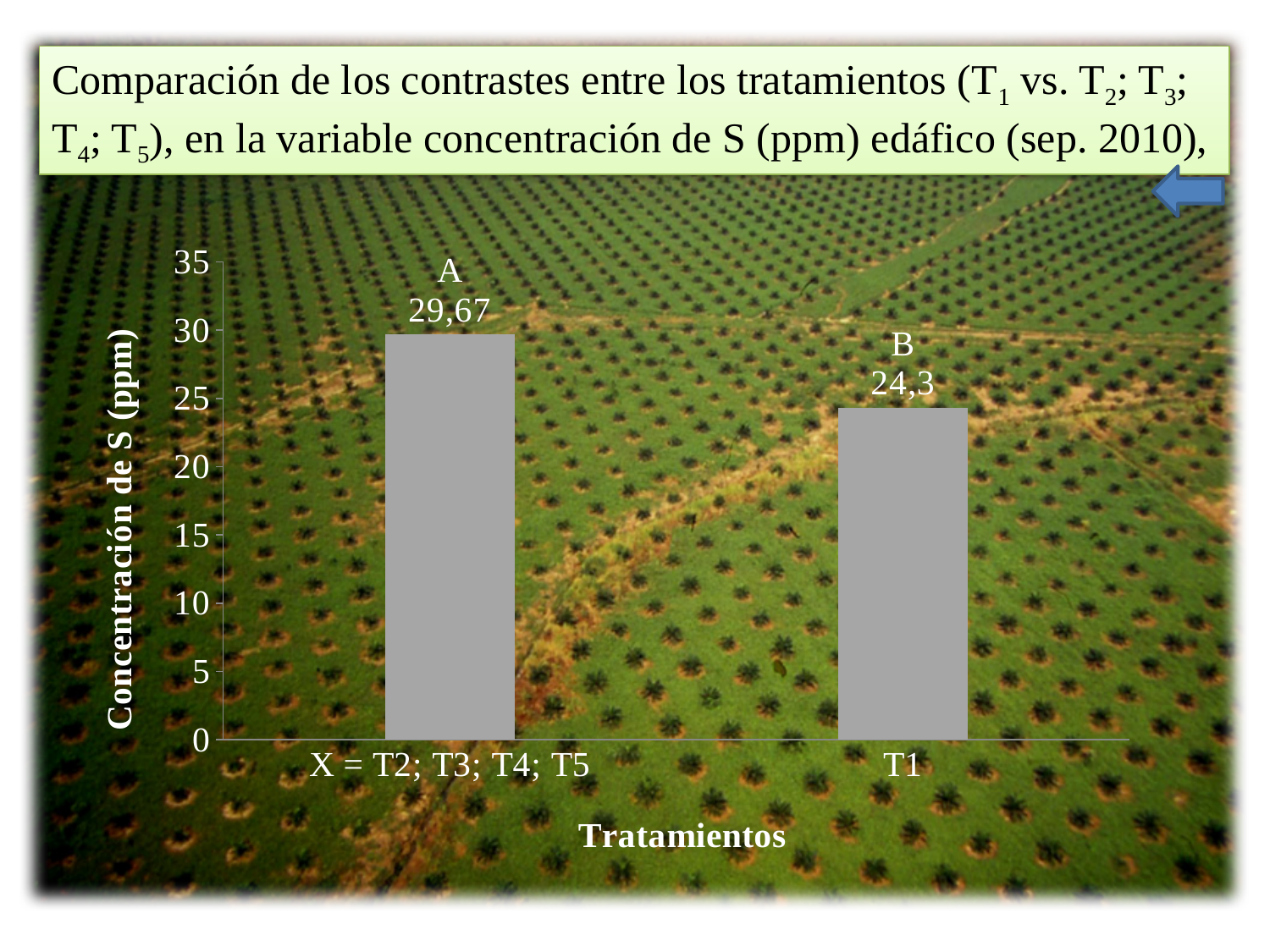
How many categories are shown on the x axis? 2 What letter is printed above the bar for T1? B What is the label of the y axis? Concentración de S (ppm) What is the difference between the S concentration for 'X = T2; T3; T4; T5' and for T1? 5,37 Which category has the highest S concentration? X = T2; T3; T4; T5 What is the S concentration value for T1? 24,3 Is the value for 'X = T2; T3; T4; T5' greater or less than 25? greater Is the value for T1 greater or less than 25? less Which category has the lowest S concentration? T1 What kind of chart is shown on the slide? bar chart Which is larger, the value for T1 or the value for 'X = T2; T3; T4; T5'? X = T2; T3; T4; T5 What is the S concentration value for the category 'X = T2; T3; T4; T5'? 29,67